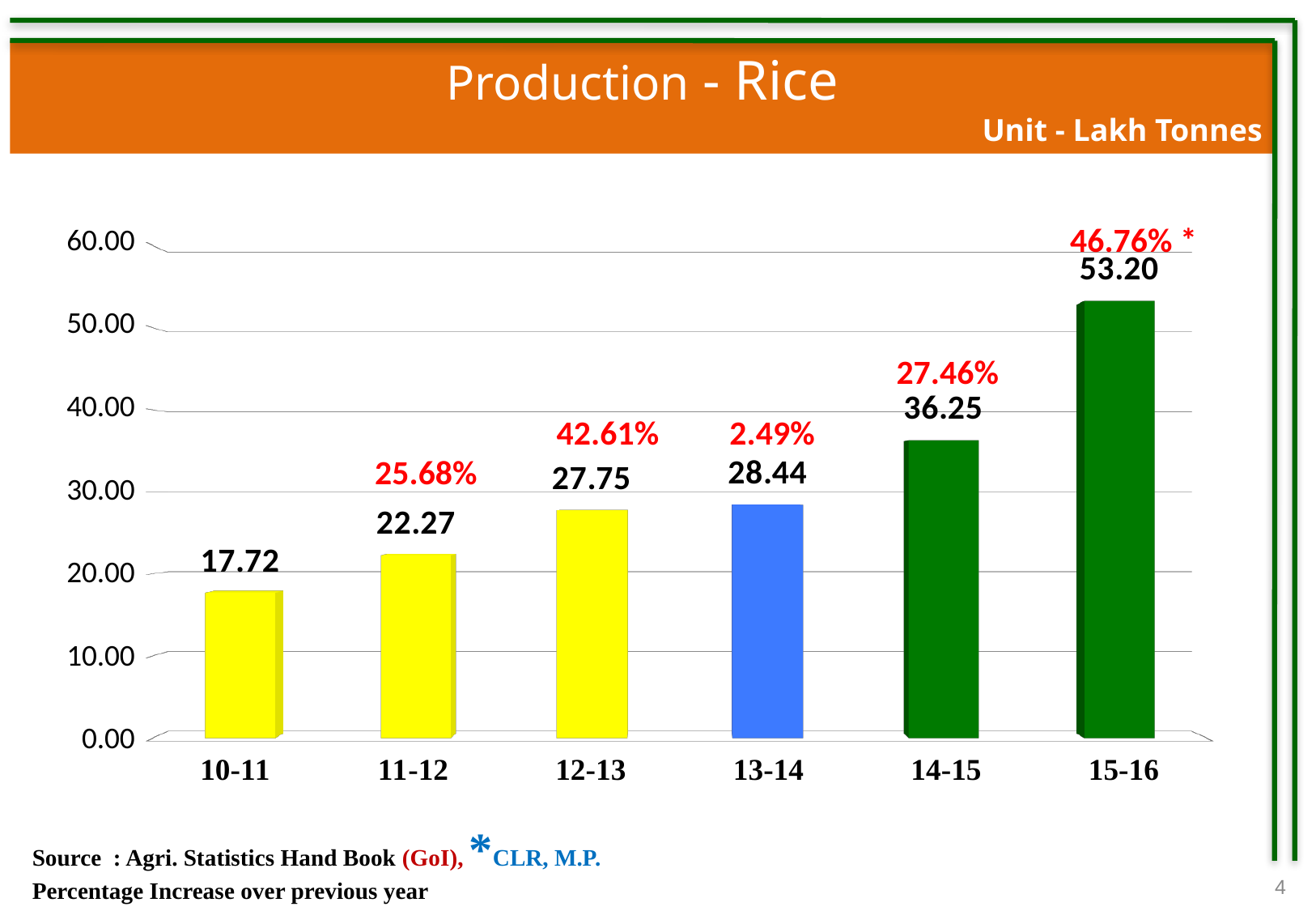
Which year has higher rice production, 11-12 or 13-14? 13-14 How many years are shown on the x axis of the chart? 6 Do the rice production values rise or fall from 10-11 to 15-16? rise Which year has the highest rice production? 15-16 What is the rice production value for 13-14? 28.44 Which year has the lowest rice production? 10-11 Is the rice production value for 14-15 greater or less than 30.00? greater What percentage increase over the previous year is shown for 12-13? 42.61% What is the difference in rice production between 15-16 and 14-15? 16.95 What kind of chart is shown on the slide? bar chart What unit is used for the values in the chart? Lakh Tonnes What is the rice production value for 10-11? 17.72